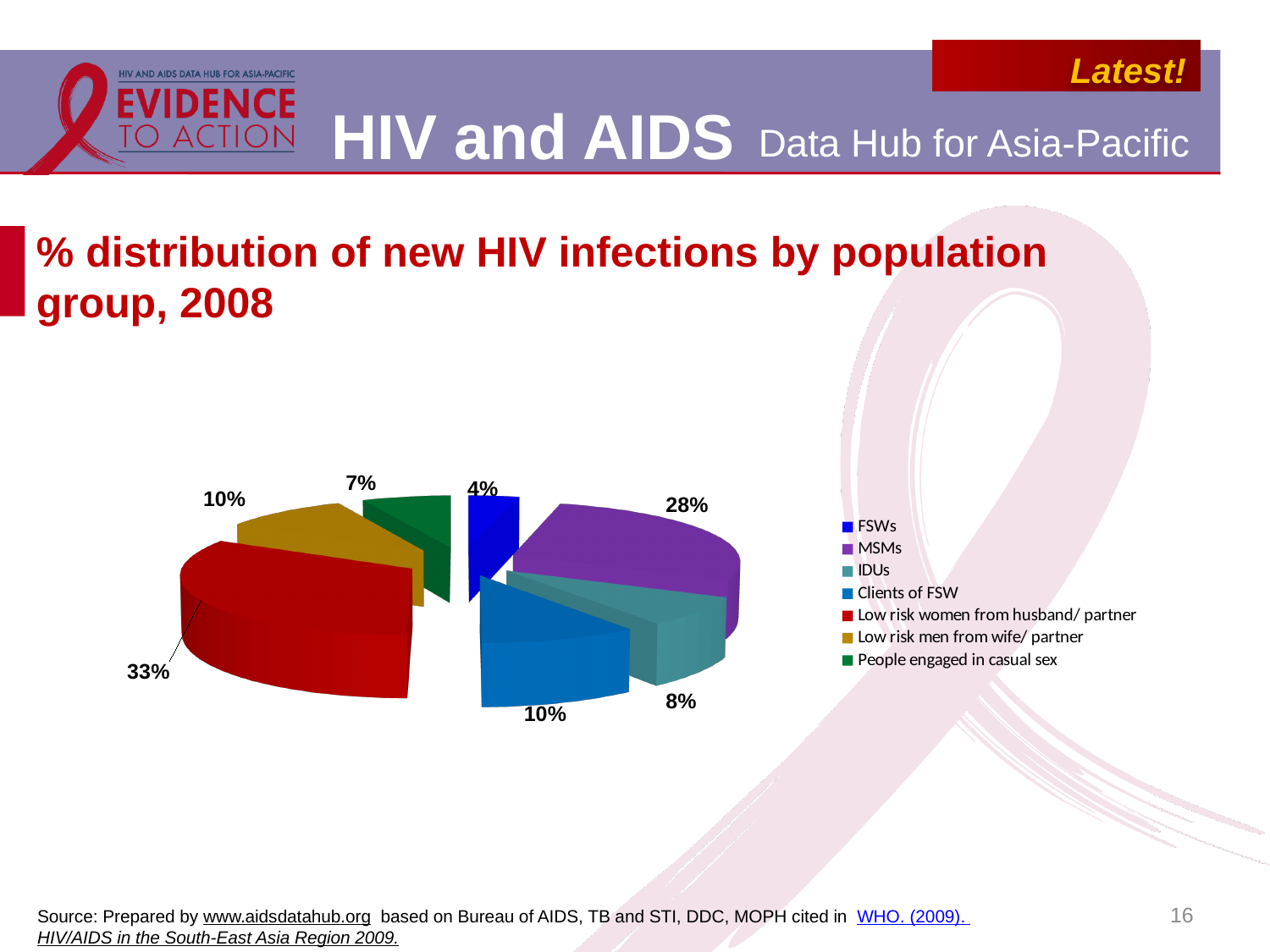
Which is larger, the share for IDUs or the share for clients of FSW? Clients of FSW What is the difference in percentage points between the share for low risk women from husband/ partner and the share for MSMs? 5 What percentage of new HIV infections is attributed to IDUs? 8% What is the title of the chart? % distribution of new HIV infections by population group, 2008 What kind of chart is shown on the slide? Pie chart Which population group accounts for the largest share of new HIV infections? Low risk women from husband/ partner How many population groups does the legend list? 7 What percentage of new HIV infections is attributed to FSWs? 4% Which population group accounts for the smallest share of new HIV infections? FSWs What percentage of new HIV infections is attributed to people engaged in casual sex? 7% What percentage of new HIV infections is attributed to MSMs? 28% What percentage of new HIV infections is attributed to low risk women from husband/ partner? 33%